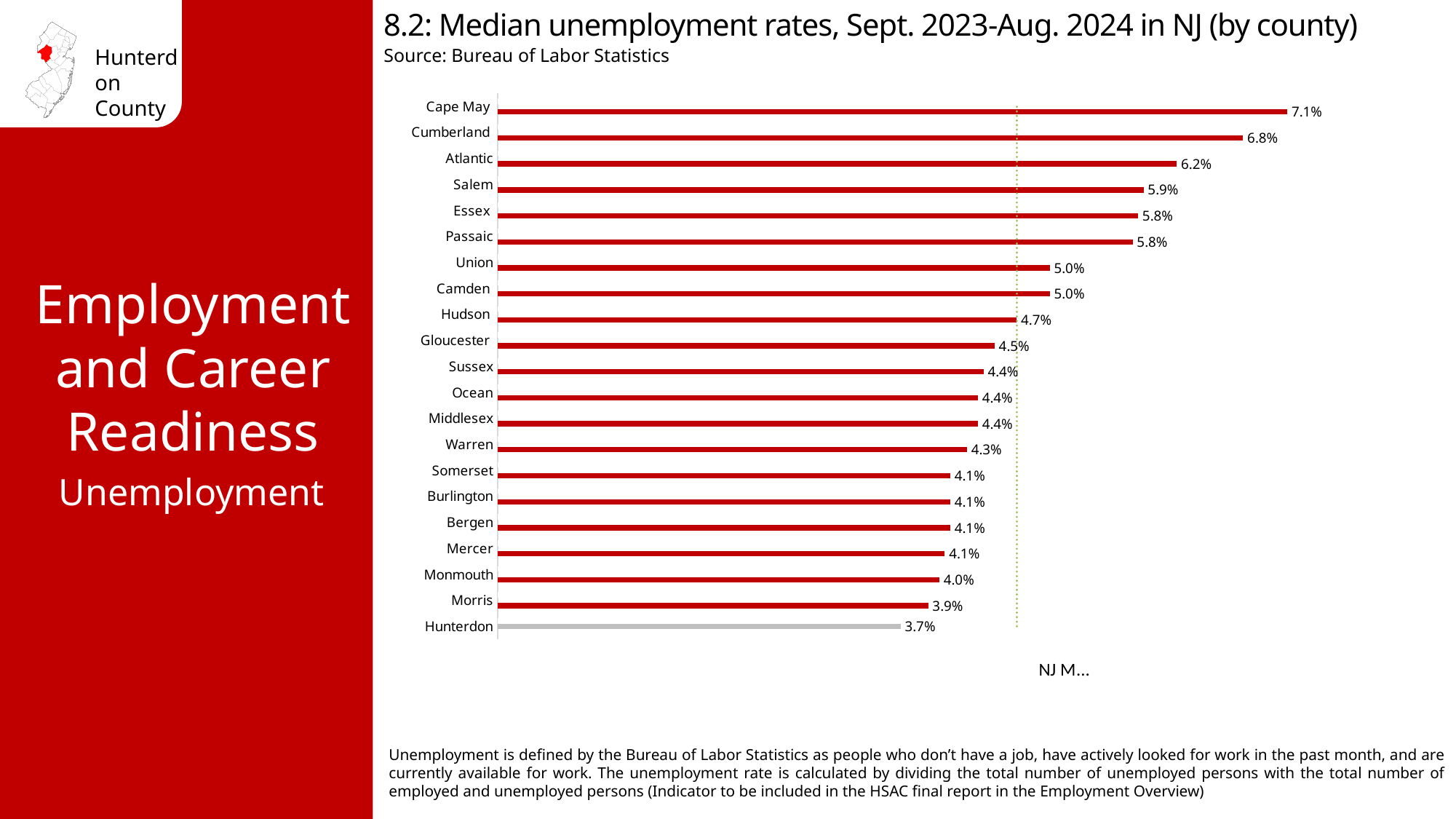
Which county's bar is shown in grey rather than red? Hunterdon What is the median unemployment rate for Hunterdon? 3.7% What is the median unemployment rate for Hudson? 4.7% Which county has the lowest median unemployment rate? Hunterdon What type of chart is shown on the slide? Bar chart What is the difference between the median unemployment rates of Cumberland and Morris? 2.9% Which county has the highest median unemployment rate? Cape May What is the median unemployment rate for Atlantic? 6.2% What is the difference between the median unemployment rates of Cape May and Hunterdon? 3.4% How many counties are shown in the chart? 21 Which has a higher median unemployment rate, Salem or Union? Salem What is the median unemployment rate for Cape May? 7.1%